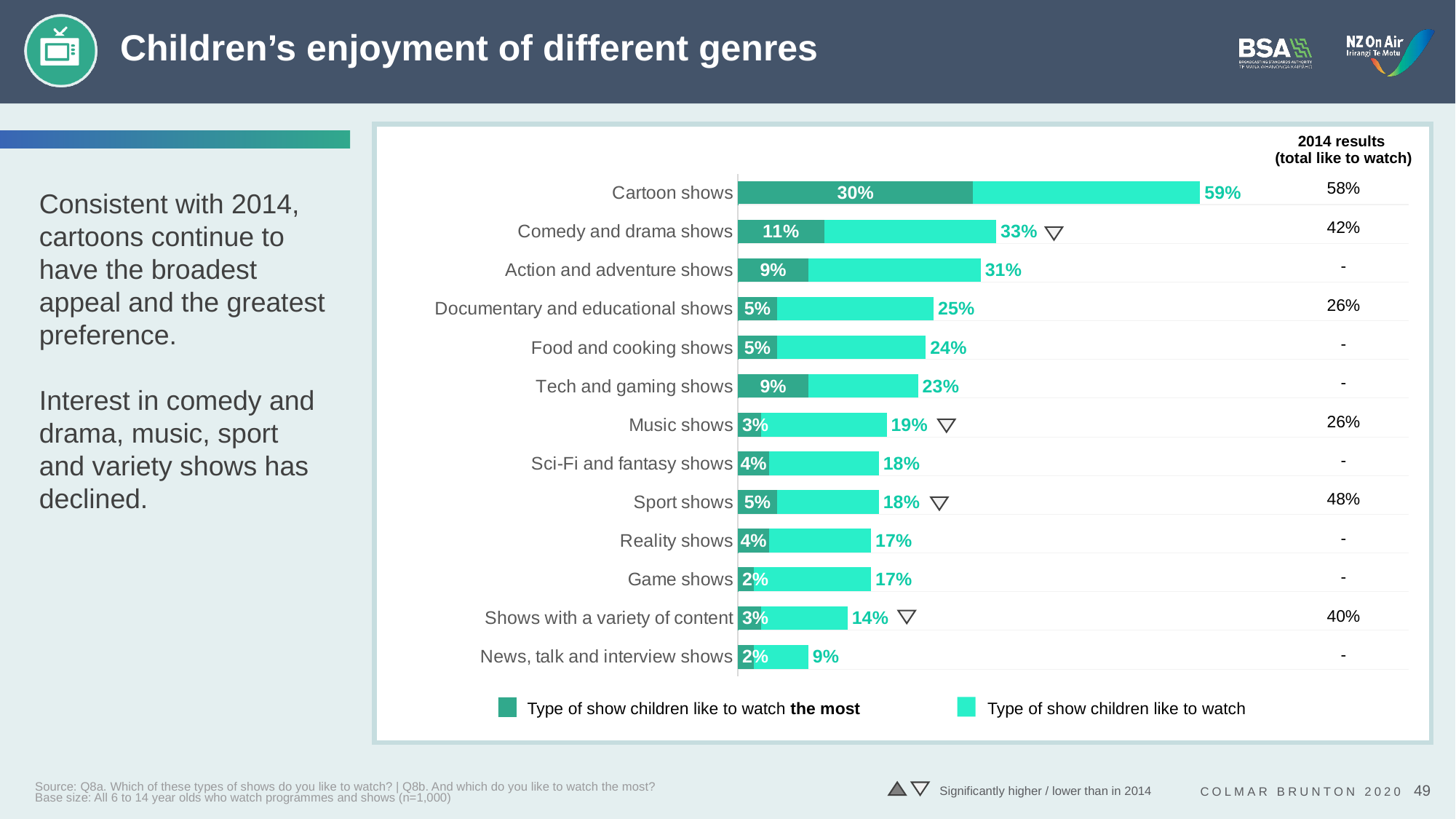
What value is printed at the end of the bar for Comedy and drama shows? 33% What percentage of children like to watch Cartoon shows the most? 30% How many genres (categories) are plotted in the chart? 13 Which legend entry is shown in the darker green colour? Type of show children like to watch the most What is the difference between the end-of-bar values for Cartoon shows (59%) and Comedy and drama shows (33%)? 26 percentage points What percentage of children like to watch Tech and gaming shows the most? 9% What type of chart is shown on the slide? bar chart How many series does the legend list? 2 Which genre has the lowest value printed at the end of its bar? News, talk and interview shows Which has a larger 'like to watch the most' value: Comedy and drama shows or Action and adventure shows? Comedy and drama shows Which genre has the highest value printed at the end of its bar? Cartoon shows What was the 2014 result (total like to watch) for Sport shows? 48%